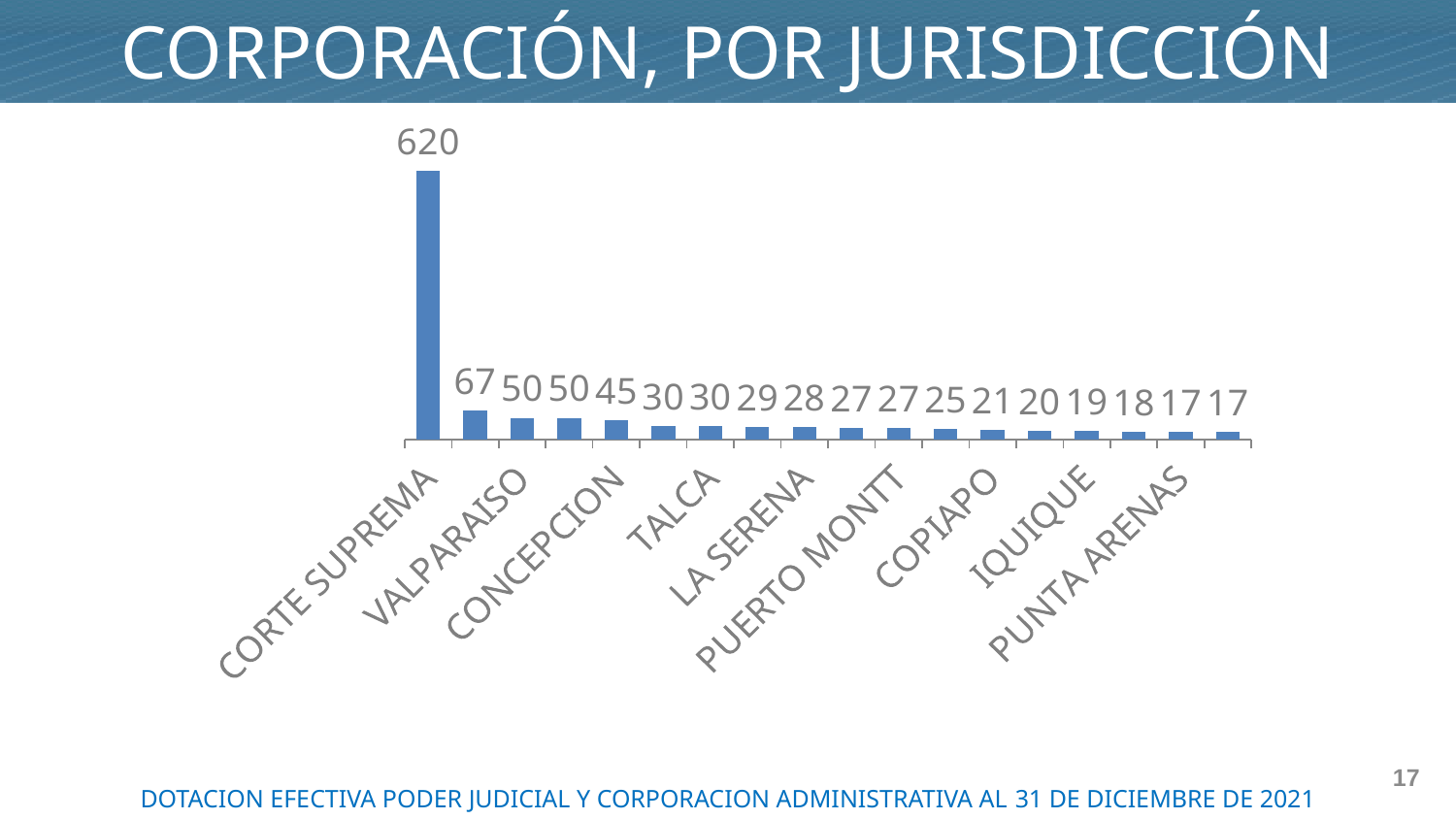
What is the value for TALCA? 30 Do the values rise or fall from left to right along the x axis? Fall What is the title of the chart? CORPORACIÓN, POR JURISDICCIÓN What is the difference between the highest value (620) and the second highest value (67)? 553 How many bars are plotted on the chart? 18 Which has a larger value, TALCA or LA SERENA? TALCA What is the value for VALPARAISO? 50 Which category has the highest value? CORTE SUPREMA What is the lowest value shown on the chart? 17 What is the value for CORTE SUPREMA? 620 What type of chart is shown on the slide? Bar chart What is the second highest value shown on the chart? 67